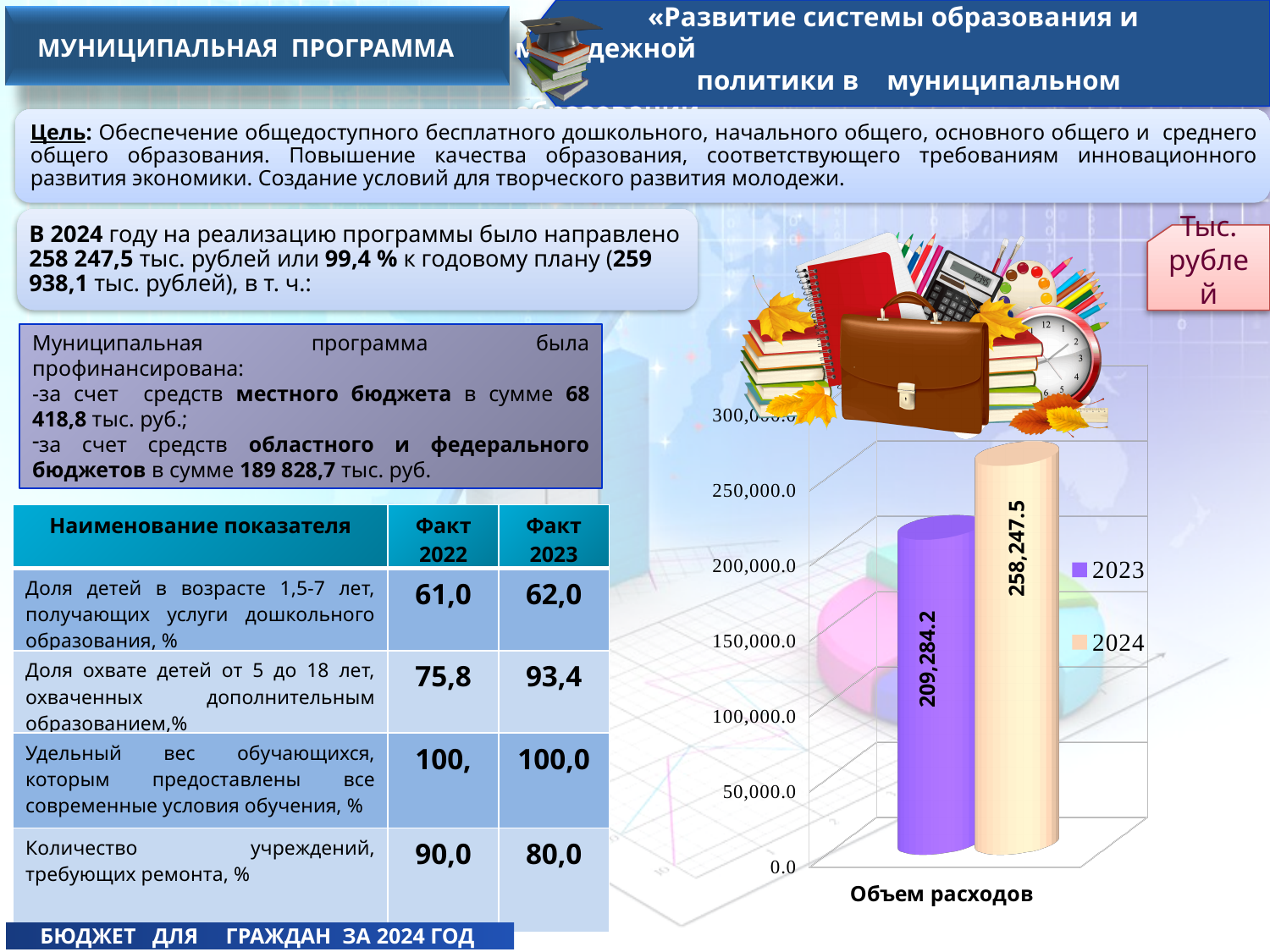
What is the difference between the 2024 value and the 2023 value in the chart? 48,963.3 How many series does the chart legend list? 2 Is the value for 2024 greater or less than 300,000.0? less Is the value for 2024 larger or smaller than the value for 2023? larger Which series has the higher value in the chart, 2023 or 2024? 2024 What is the value for the 2024 series in the chart? 258,247.5 How many categories are shown on the x axis of the chart? 1 Is the value for 2023 greater or less than 150,000.0? greater What kind of chart is shown on the slide? bar chart Which series has the lower value in the chart? 2023 What is the value for the 2023 series in the chart? 209,284.2 What is the category label shown under the bars on the x axis? Объем расходов